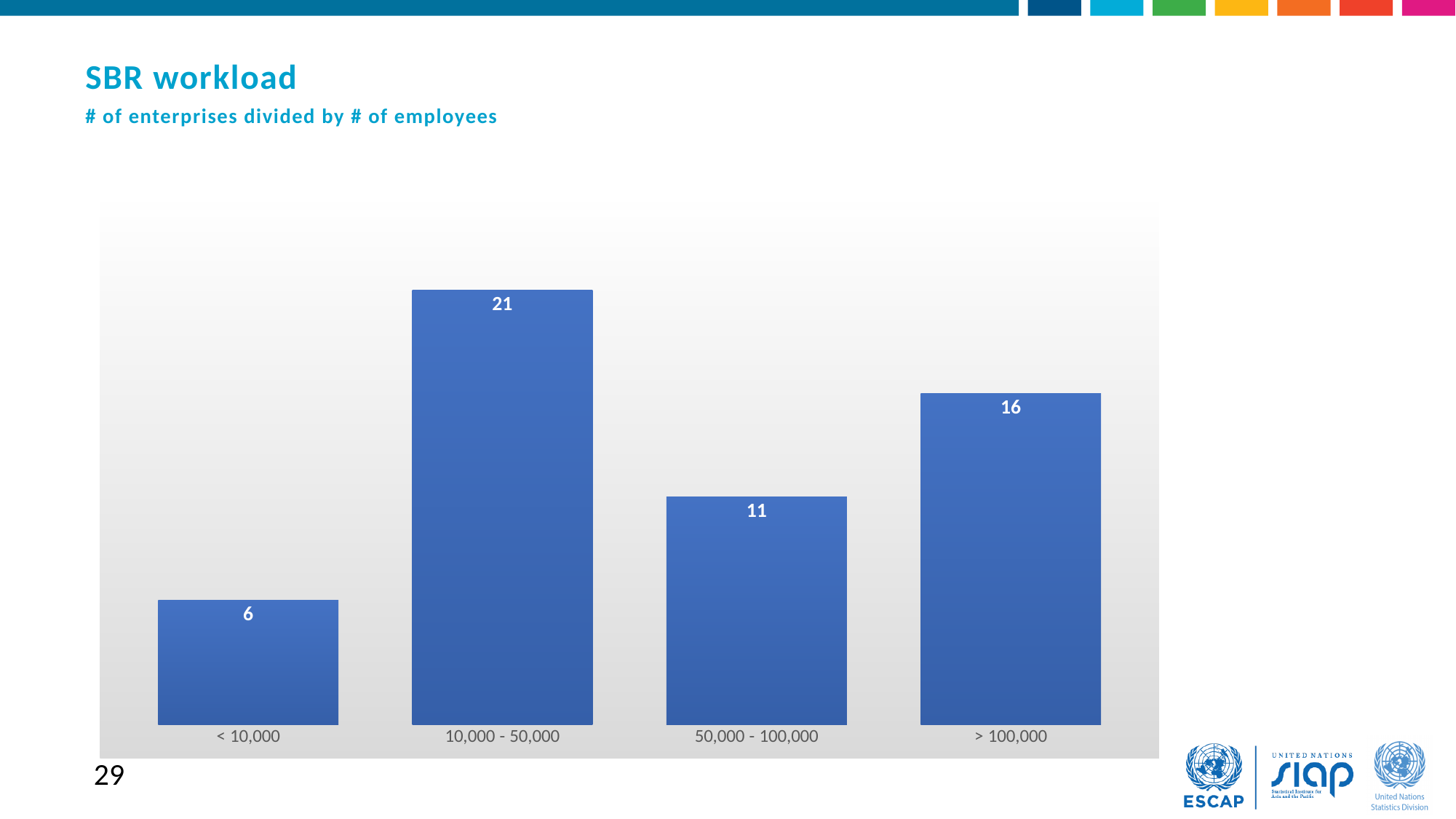
What is the value for the > 100,000 category? 16 What is the value for the < 10,000 category? 6 Which category has the highest value? 10,000 - 50,000 What is the value for the 10,000 - 50,000 category? 21 What is the value for the 50,000 - 100,000 category? 11 Which is larger, the value for 50,000 - 100,000 or the value for > 100,000? > 100,000 Which category has the lowest value? < 10,000 What is the difference between the values for 50,000 - 100,000 and < 10,000? 5 What is the title of the slide containing the chart? SBR workload What is the difference between the values for 10,000 - 50,000 and > 100,000? 5 How many categories are shown in the chart? 4 What kind of chart is shown on the slide? Bar chart